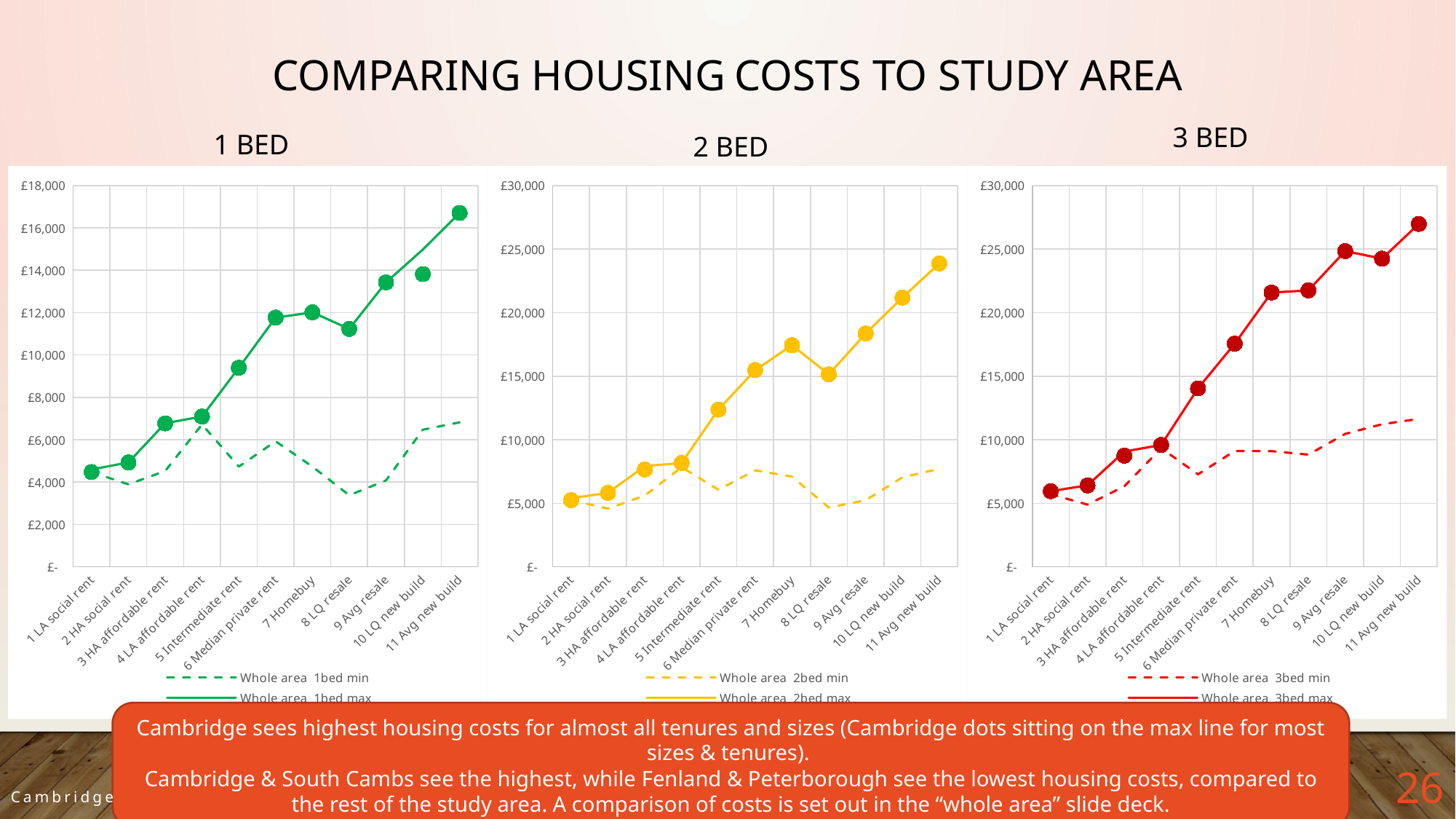
How many categories are shown on the x axis of the 2 BED chart? 11 In the 3 BED chart, is the 'Whole area 3bed max' value for 11 Avg new build greater or less than £25,000? greater In the 3 BED chart, is the 'Whole area 3bed max' value for 5 Intermediate rent greater or less than £15,000? less What kind of chart is the 1 BED chart? line chart In the 3 BED chart, which category has the highest value on the 'Whole area 3bed max' line? 11 Avg new build In the 2 BED chart, is the 'Whole area 2bed max' value for 11 Avg new build greater or less than £25,000? less In the 2 BED chart, do the values on the 'Whole area 2bed max' line generally rise or fall from left to right along the x axis? rise What colour is the line in the 3 BED chart? red In the 1 BED chart, which category has the lowest value on the dashed 'Whole area 1bed min' line? 8 LQ resale In the 1 BED chart, which category has the highest value on the 'Whole area 1bed max' line? 11 Avg new build In the 2 BED chart, which is larger on the 'Whole area 2bed max' line: 7 Homebuy or 8 LQ resale? 7 Homebuy